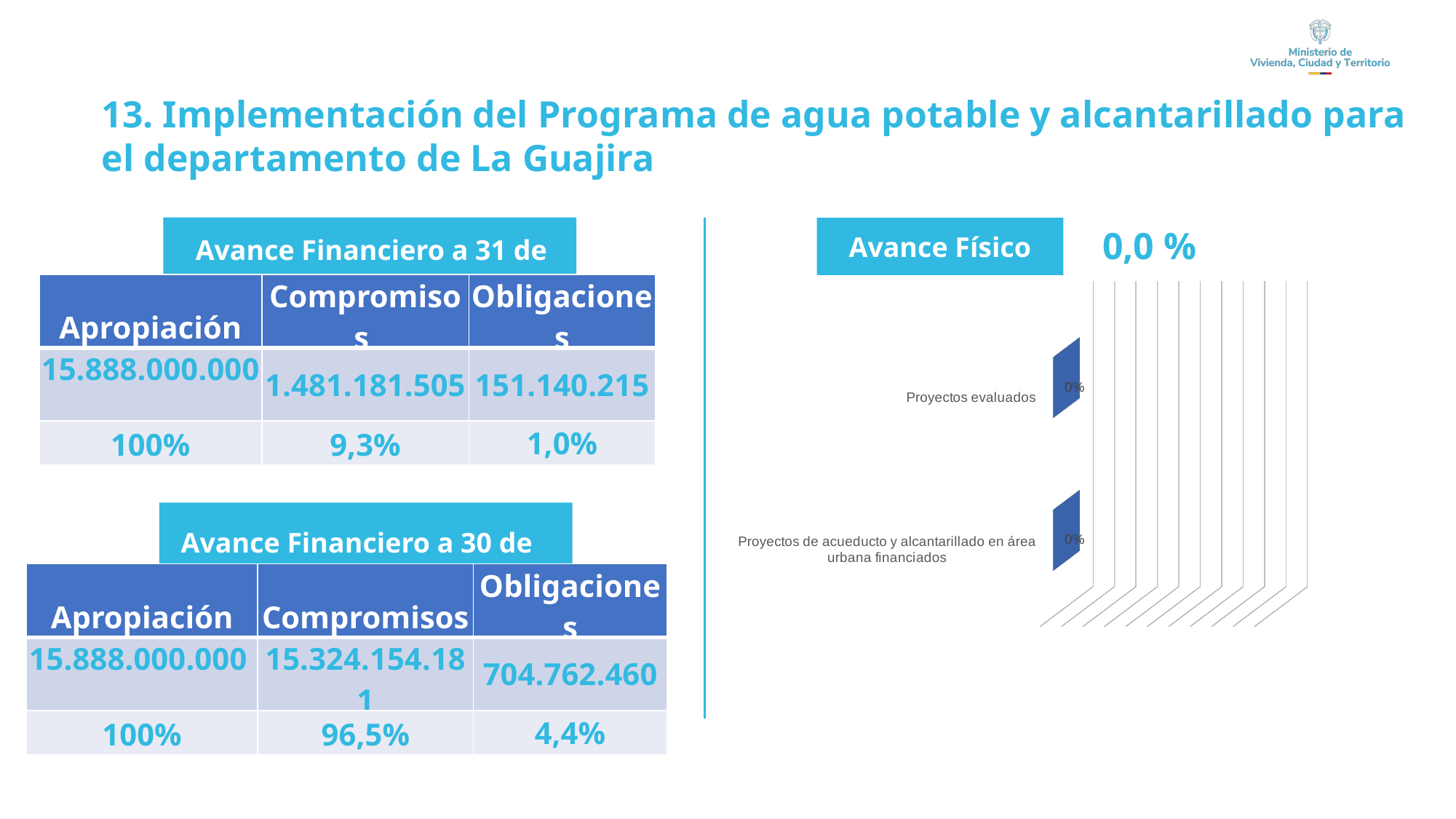
Are the bars in the Avance Físico chart horizontal or vertical? horizontal What is the value shown for "Proyectos evaluados" in the Avance Físico chart? 0% What is the value shown for "Proyectos de acueducto y alcantarillado en área urbana financiados" in the Avance Físico chart? 0% What kind of chart is the Avance Físico chart? bar chart How many categories are plotted in the Avance Físico chart? 2 What overall percentage is displayed next to the "Avance Físico" heading above the chart? 0,0 % Is the value for "Proyectos evaluados" in the Avance Físico chart greater than 0%? no